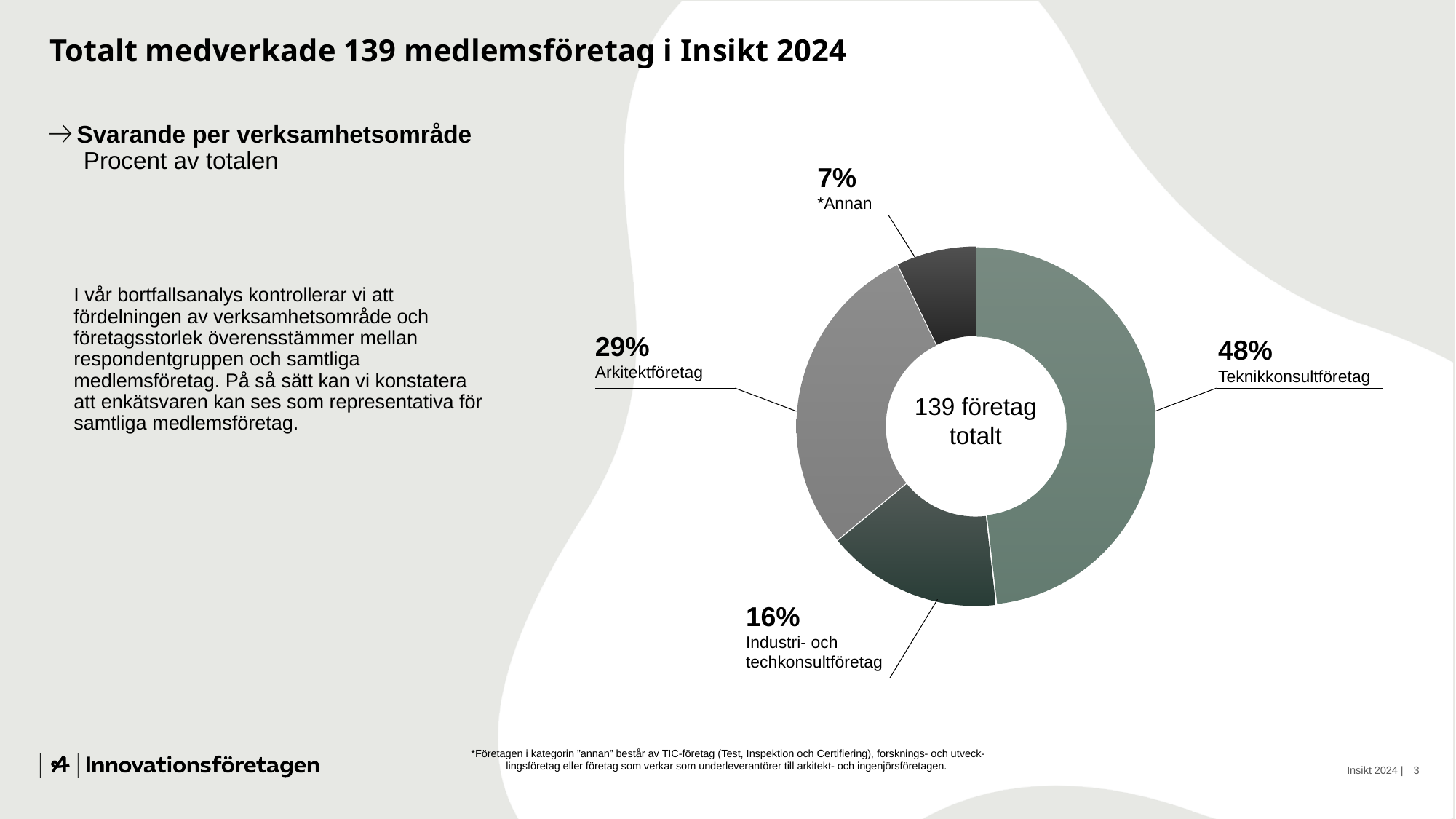
How many categories are shown in the donut chart? 4 What text is shown in the centre of the donut chart? 139 företag totalt What kind of chart is shown on the slide? Donut (pie) chart Which category has the largest share in the donut chart? Teknikkonsultföretag What share of the donut chart is Industri- och techkonsultföretag? 16% What share of the donut chart is Teknikkonsultföretag? 48% Which has a larger share, Arkitektföretag or Industri- och techkonsultföretag? Arkitektföretag What is the combined share of Arkitektföretag and *Annan? 36% Which category has the smallest share in the donut chart? *Annan What is the difference in percentage points between Teknikkonsultföretag and Arkitektföretag? 19 What share of the donut chart is Arkitektföretag? 29% What share of the donut chart is *Annan? 7%